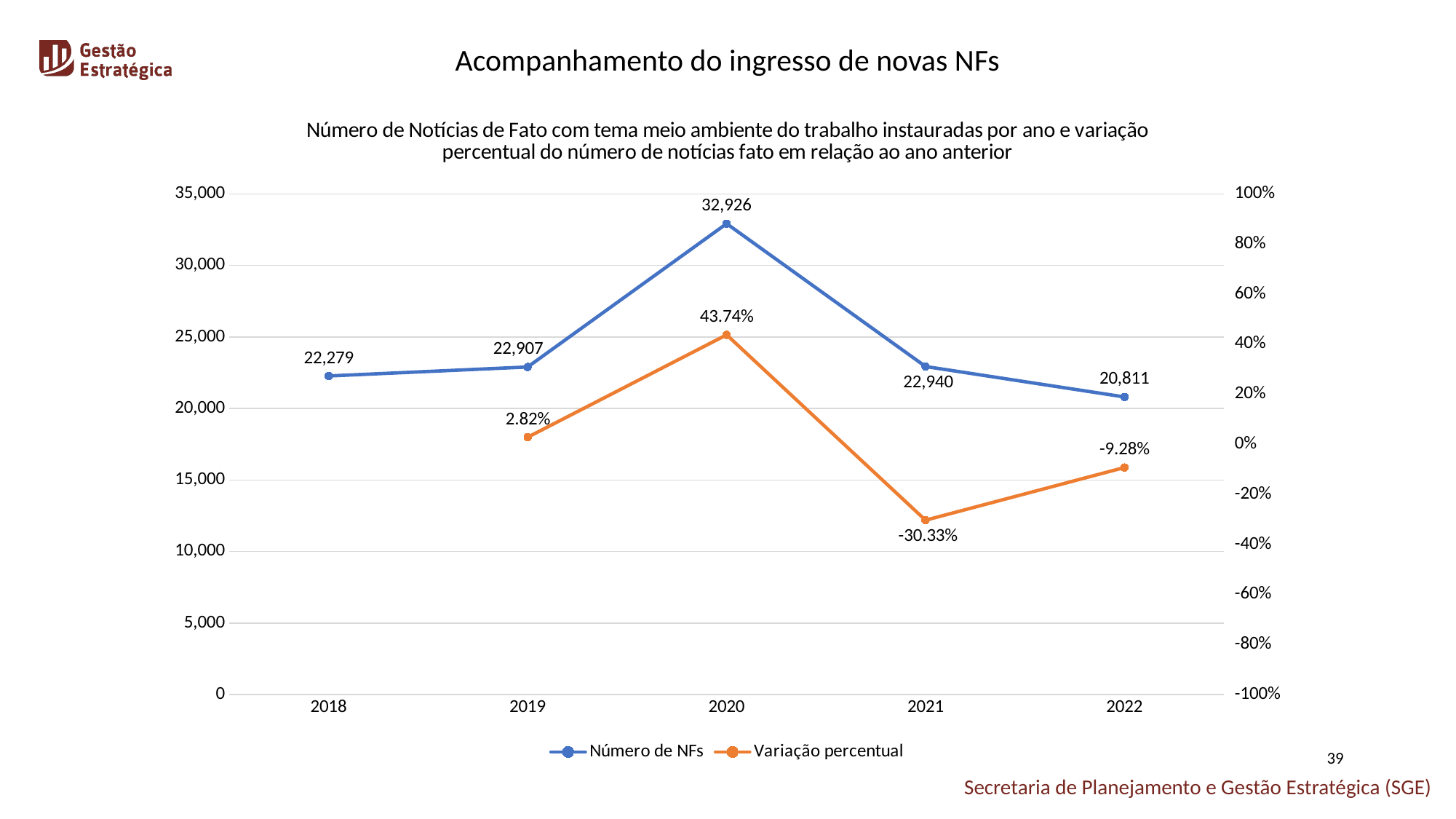
What is the value of Número de NFs for 2018? 22,279 Which year has the highest Número de NFs? 2020 Which is larger, the Número de NFs for 2019 or for 2021? 2021 What is the Variação percentual for 2021? -30.33% What is the value of Número de NFs for 2020? 32,926 What is the difference in Número de NFs between 2020 and 2021? 9,986 Is the Número de NFs for 2022 greater or less than 25,000? less Which year has the lowest Número de NFs? 2022 What kind of chart is shown on the slide? line chart How many years are shown on the x axis? 5 How many series does the legend list? 2 Which year has the lowest Variação percentual? 2021